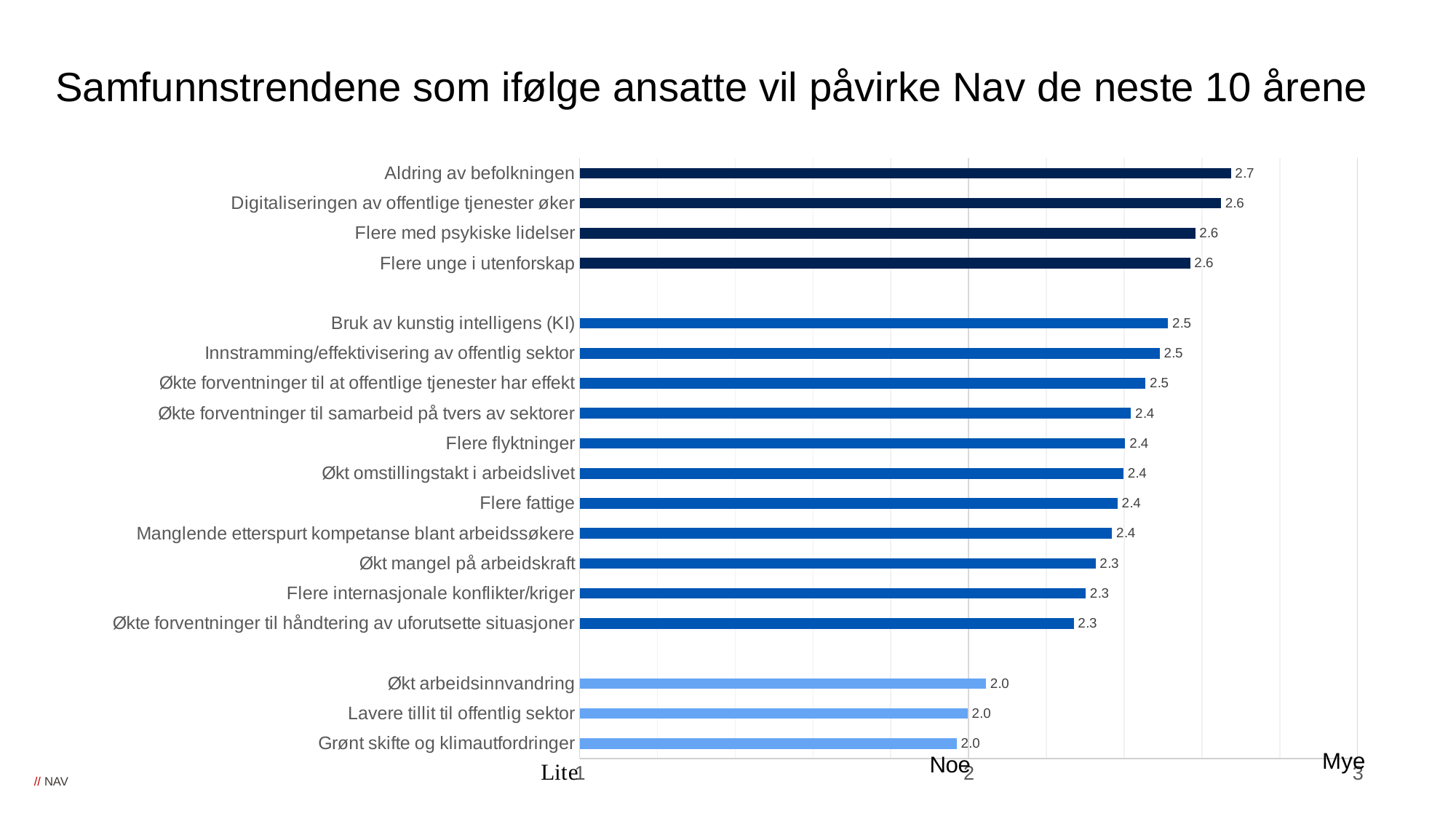
What is the difference between the values for Aldring av befolkningen and Økt arbeidsinnvandring? 0.7 Which category has the highest value? Aldring av befolkningen What value is shown for Aldring av befolkningen? 2.7 What is the title of the chart? Samfunnstrendene som ifølge ansatte vil påvirke Nav de neste 10 årene What kind of chart is shown on the slide? Bar chart Which has a larger value, Flere flyktninger or Lavere tillit til offentlig sektor? Flere flyktninger How many categories are shown on the chart? 18 What value is shown for Økt mangel på arbeidskraft? 2.3 What value is shown for Bruk av kunstig intelligens (KI)? 2.5 What is the lowest value shown on the chart? 2.0 What value is shown for Grønt skifte og klimautfordringer? 2.0 Is the value for Innstramming/effektivisering av offentlig sektor greater or less than 2? greater